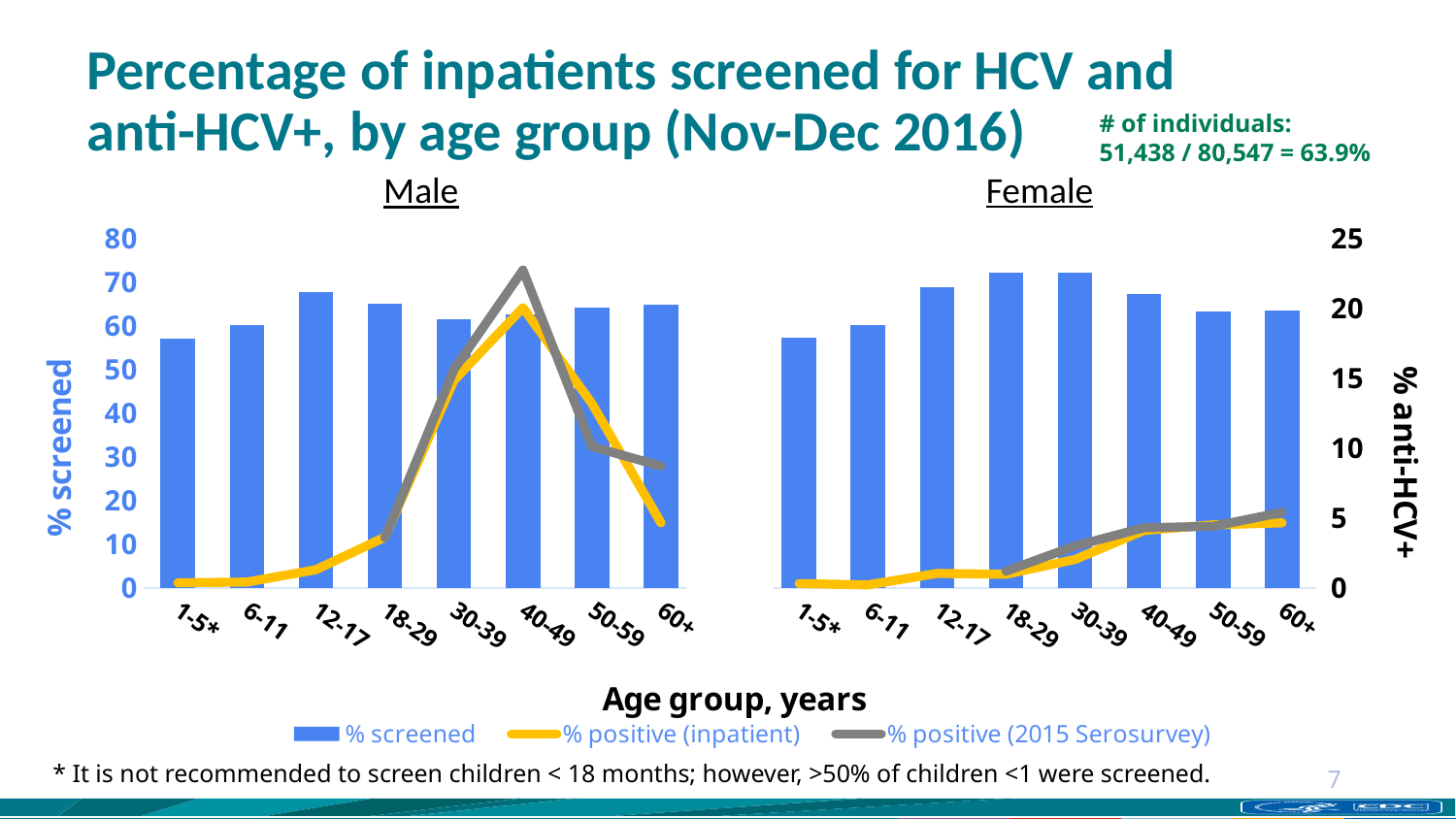
How many series does the legend list? 3 In the Male chart, is the % positive (inpatient) value for 40-49 greater or less than 15? greater In the Male chart, which age group has the highest % screened bar? 12-17 How many age-group categories are shown on the x axis of the Male chart? 8 What kind of chart is used to show % screened in the Male and Female charts? Bar chart In the Female chart, is the % screened value for 18-29 greater or less than 70? greater In the Female chart, which age group has the lowest % screened bar? 1-5* In the Male chart, is the % screened value for 12-17 greater or less than 60? greater In the Male chart, at age group 40-49, which is larger: % positive (inpatient) or % positive (2015 Serosurvey)? % positive (2015 Serosurvey) In the Female chart, does the % positive (inpatient) line generally rise or fall from the youngest to the oldest age group? Rise What is the label of the right-hand vertical axis? % anti-HCV+ In the Male chart, which age group has the lowest % screened bar? 1-5*